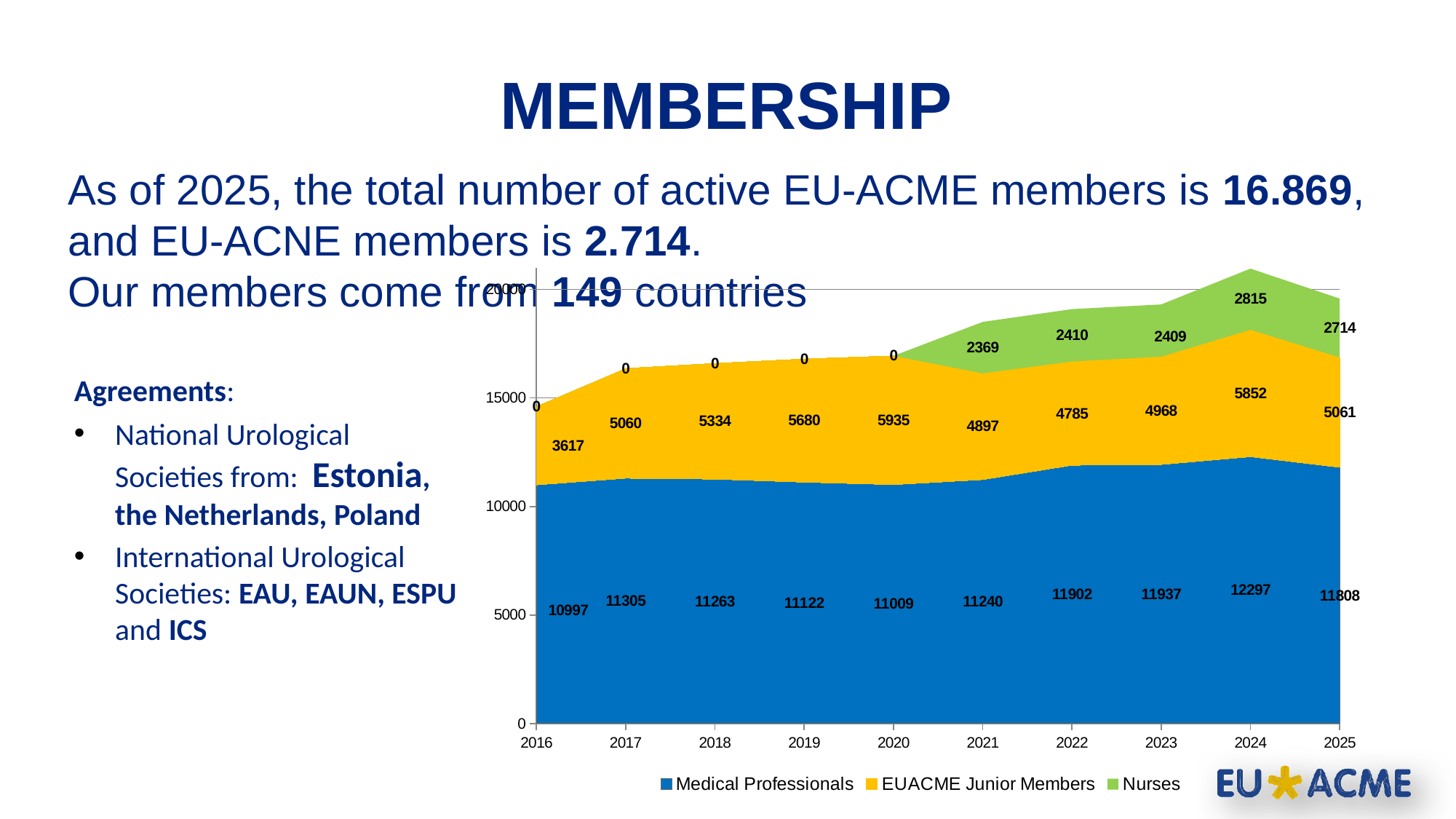
How many series does the chart legend list? 3 What is the difference between the Nurses values in 2024 and 2025? 101 How many years are plotted along the x axis of the chart? 10 What is the total of all three series in 2024? 20964 In which year is the EUACME Junior Members value lowest? 2016 What kind of chart is shown on the slide? Stacked area chart Which is larger, the EUACME Junior Members value in 2019 or in 2023? 2019 What is the value for Nurses in 2021? 2369 In which year is the Medical Professionals value highest? 2024 What is the value for Medical Professionals in 2025? 11808 What is the value for EUACME Junior Members in 2020? 5935 Which series is shown in green in the chart? Nurses